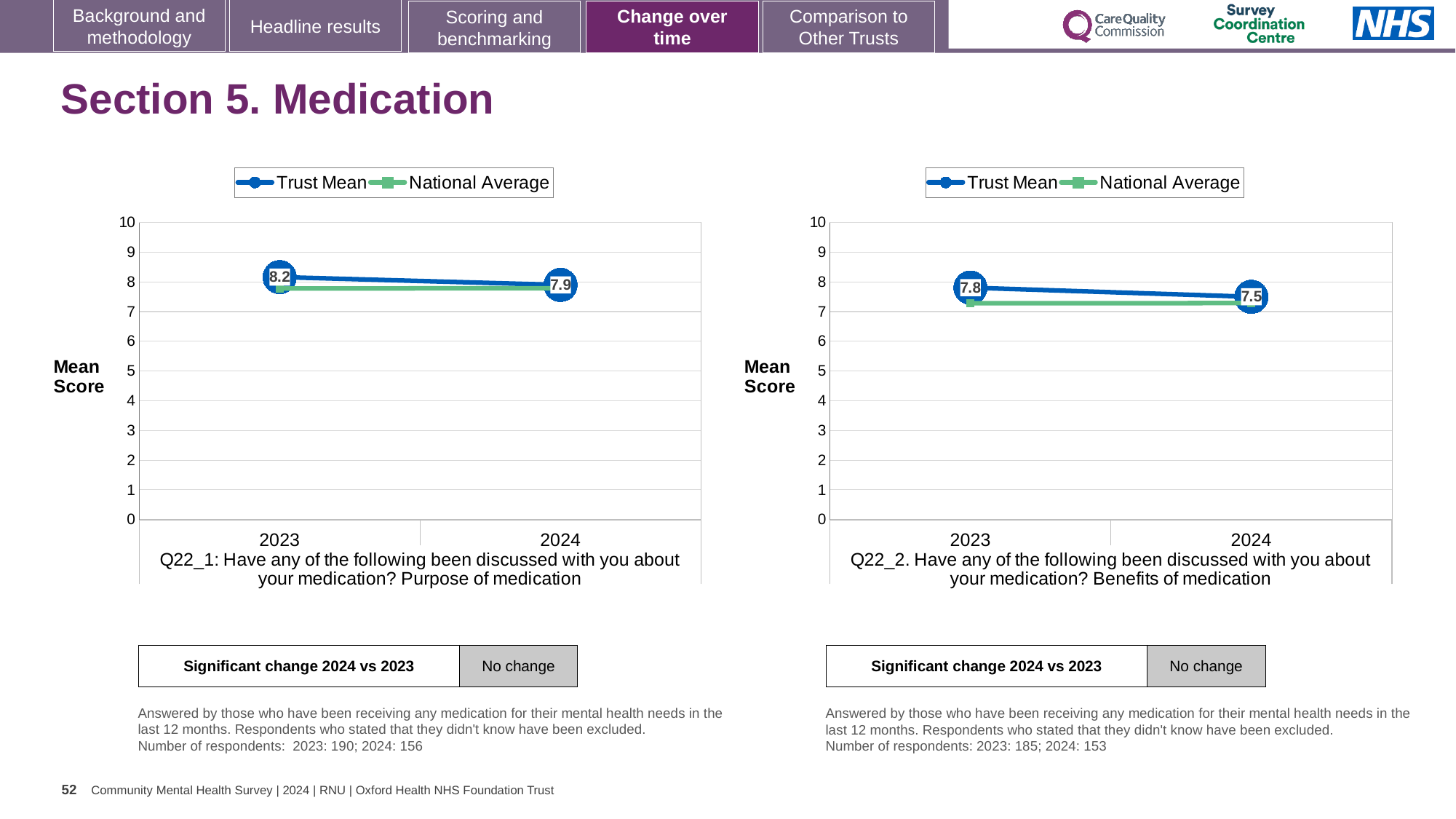
In the right chart (Q22_2), is the National Average value for 2023 greater or less than 8? less In the left chart (Q22_1), which is larger for 2023: the Trust Mean or the National Average? Trust Mean In the left chart (Q22_1), by how much did the Trust Mean change from 2023 to 2024? 0.3 How many years are shown on the x axis of the left chart (Q22_1)? 2 In the right chart (Q22_2: Benefits of medication), what is the Trust Mean score for 2023? 7.8 In the right chart (Q22_2), does the Trust Mean rise or fall from 2023 to 2024? fall In the right chart (Q22_2), by how much did the Trust Mean change from 2023 to 2024? 0.3 In the left chart (Q22_1: Purpose of medication), what is the Trust Mean score for 2024? 7.9 In the left chart (Q22_1: Purpose of medication), what is the Trust Mean score for 2023? 8.2 What kind of chart is the left chart (Q22_1)? line chart How many series does the legend of the right chart (Q22_2) list? 2 In the right chart (Q22_2: Benefits of medication), what is the Trust Mean score for 2024? 7.5